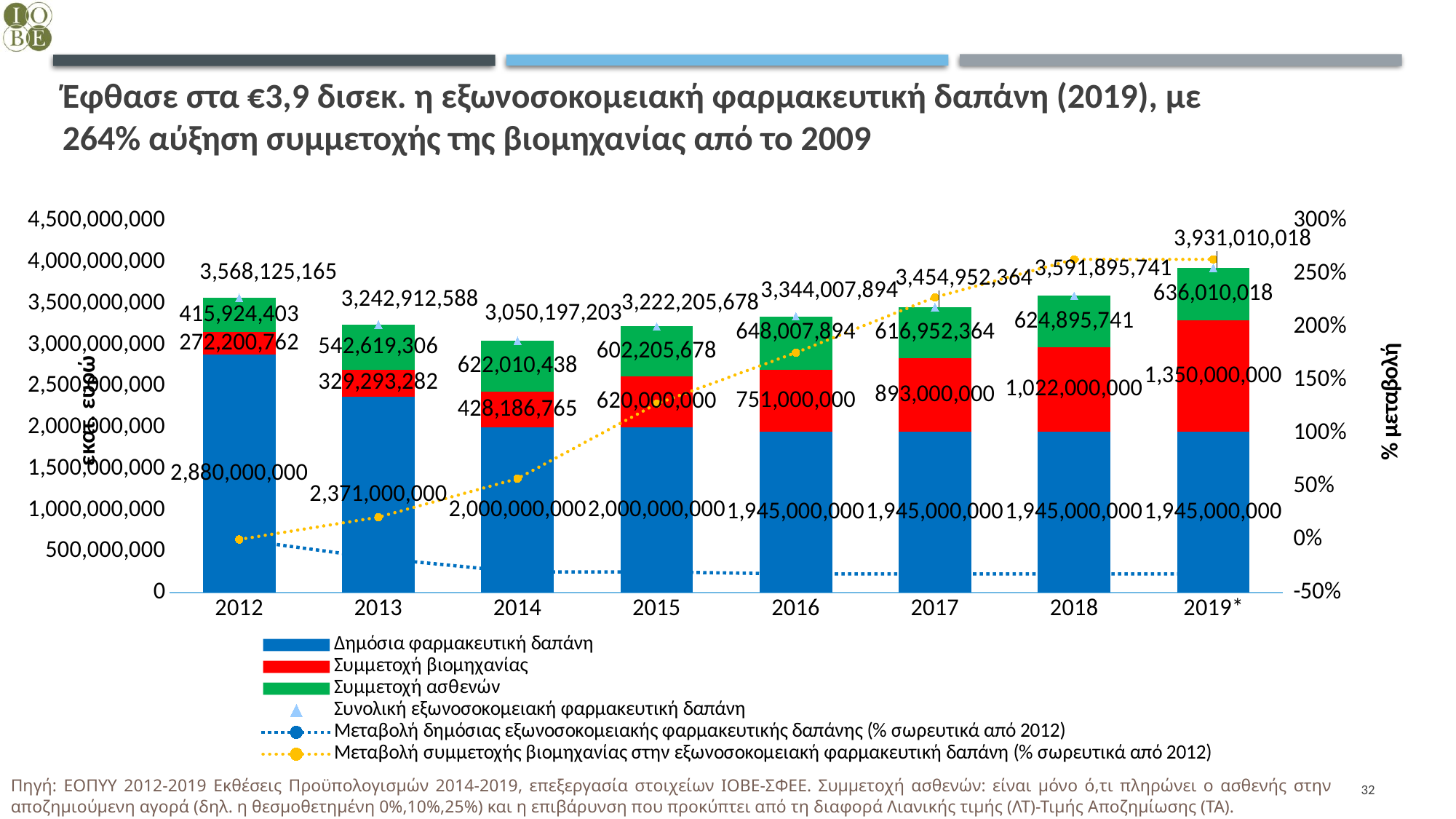
Which year has the lowest Συνολική εξωνοσοκομειακή φαρμακευτική δαπάνη? 2014 How many series does the legend list? 6 Which year has the highest Συνολική εξωνοσοκομειακή φαρμακευτική δαπάνη? 2019* What is the value of Συμμετοχή βιομηχανίας for 2019*? 1,350,000,000 What kind of chart is used for the expenditure values? Stacked bar chart Which year has the larger Συμμετοχή ασθενών, 2016 or 2017? 2016 Does Συμμετοχή βιομηχανίας rise or fall from 2012 to 2019*? Rises What is the value of Συμμετοχή ασθενών for 2013? 542,619,306 What is the value of Δημόσια φαρμακευτική δαπάνη for 2012? 2,880,000,000 What is the Συνολική εξωνοσοκομειακή φαρμακευτική δαπάνη for 2014? 3,050,197,203 How many years are shown on the x axis? 8 By how much did Συμμετοχή βιομηχανίας increase from 2018 to 2019*? 328,000,000